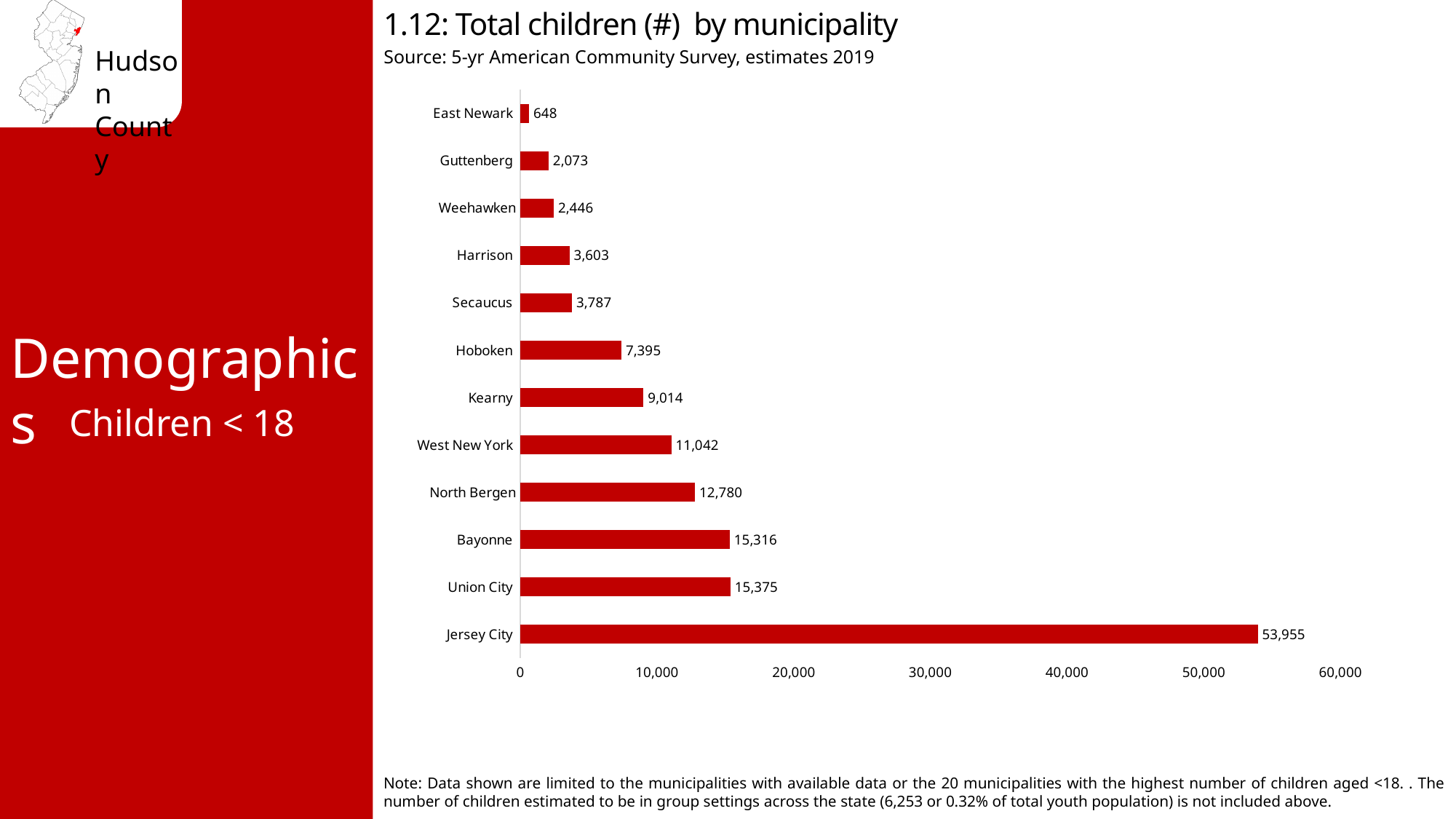
What is the source of the data in the chart? 5-yr American Community Survey, estimates 2019 What is the total number of children in Jersey City? 53,955 Which municipality has the lowest number of children? East Newark What is the difference in the number of children between North Bergen and West New York? 1,738 What is the total number of children in Hoboken? 7,395 What is the difference in the number of children between Union City and Bayonne? 59 What is the total number of children in East Newark? 648 Which has more children, Kearny or Secaucus? Kearny How many municipalities are shown in the chart? 12 What type of chart is used to show total children by municipality? Bar chart Which municipality has the highest number of children? Jersey City Is the value for Jersey City greater or less than 50,000? greater